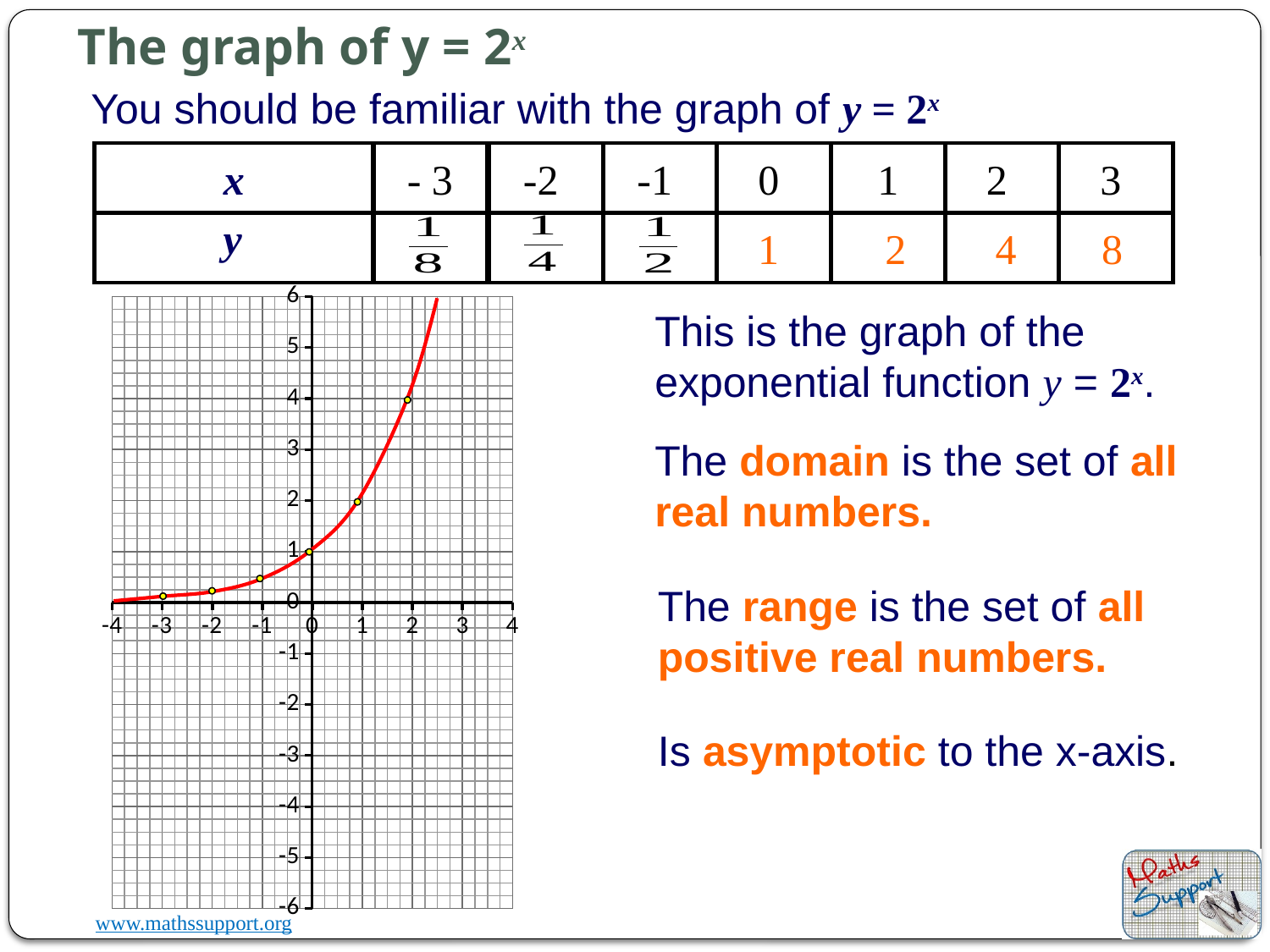
According to the table, what is the value of y when x = -2? 1/4 Is the value of y at x = 2 on the graph greater or less than 3? greater According to the table, what is the value of y when x = -3? 1/8 What is the title of the slide containing the graph? The graph of y = 2^x Do the values of y rise or fall as x increases along the x axis? rise According to the table, what is the value of y when x = 3? 8 Which is larger, the y value at x = 2 or the y value at x = -1? x = 2 According to the table, what is the value of y when x = 0? 1 How many x values are listed in the table? 7 What is the difference between the y values at x = 3 and x = 1 in the table? 6 How many plotted points are marked on the curve in the graph? 6 What kind of chart is shown on the slide? line chart